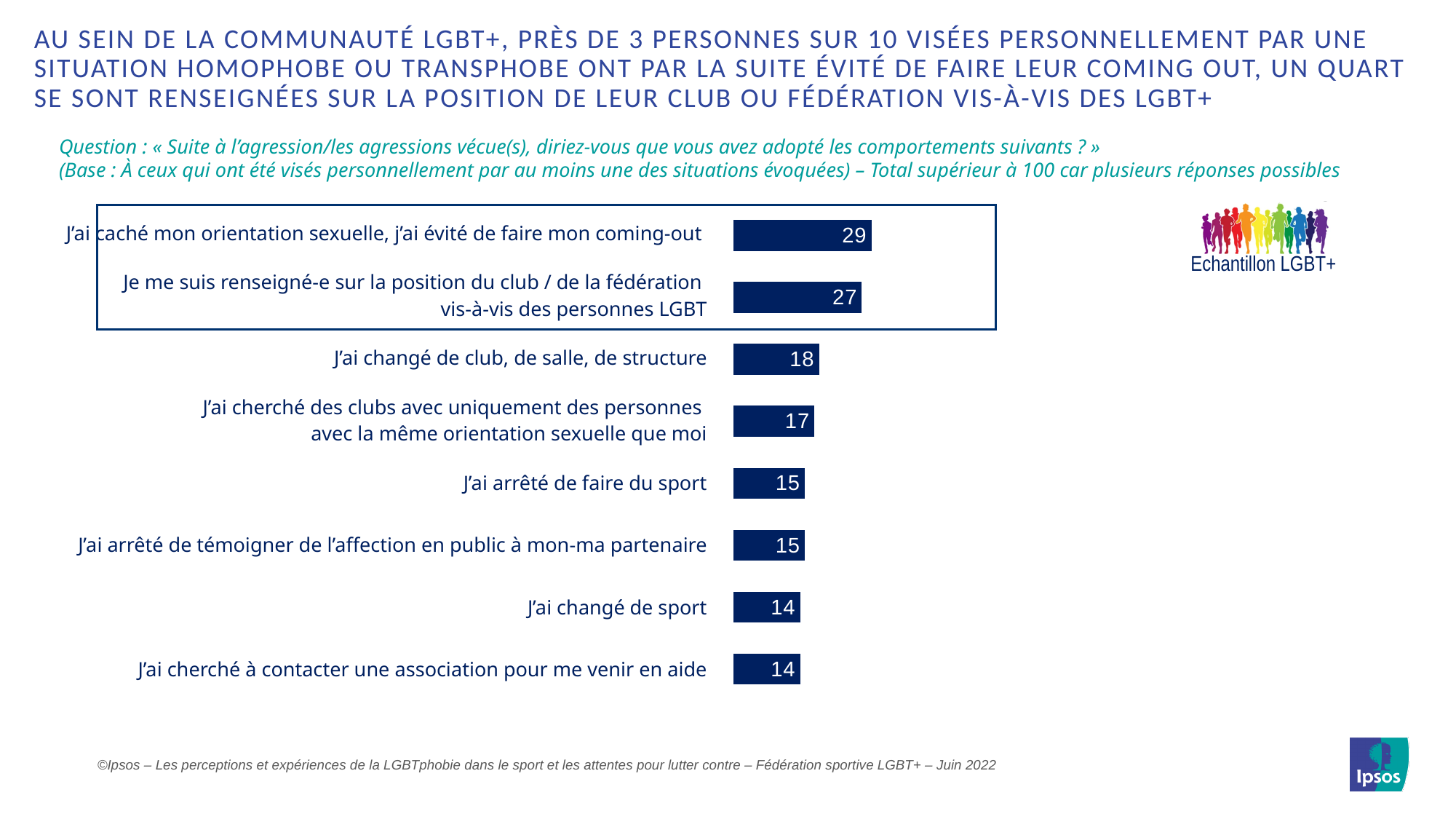
What kind of chart is shown on the slide? Bar chart Which is larger: the value for "J'ai changé de club, de salle, de structure" or the value for "J'ai arrêté de faire du sport"? J'ai changé de club, de salle, de structure What is the value for "J'ai cherché à contacter une association pour me venir en aide"? 14 What sample label appears next to the chart? Echantillon LGBT+ What is the value for "Je me suis renseigné-e sur la position du club / de la fédération vis-à-vis des personnes LGBT"? 27 What is the value for "J'ai arrêté de faire du sport"? 15 What is the difference between the values for "J'ai caché mon orientation sexuelle, j'ai évité de faire mon coming-out" and "Je me suis renseigné-e sur la position du club / de la fédération vis-à-vis des personnes LGBT"? 2 Which category has the highest value? J'ai caché mon orientation sexuelle, j'ai évité de faire mon coming-out What is the difference between the values for "J'ai changé de club, de salle, de structure" and "J'ai changé de sport"? 4 How many categories are shown in the chart? 8 What is the value for "J'ai caché mon orientation sexuelle, j'ai évité de faire mon coming-out"? 29 What is the value for "J'ai changé de club, de salle, de structure"? 18